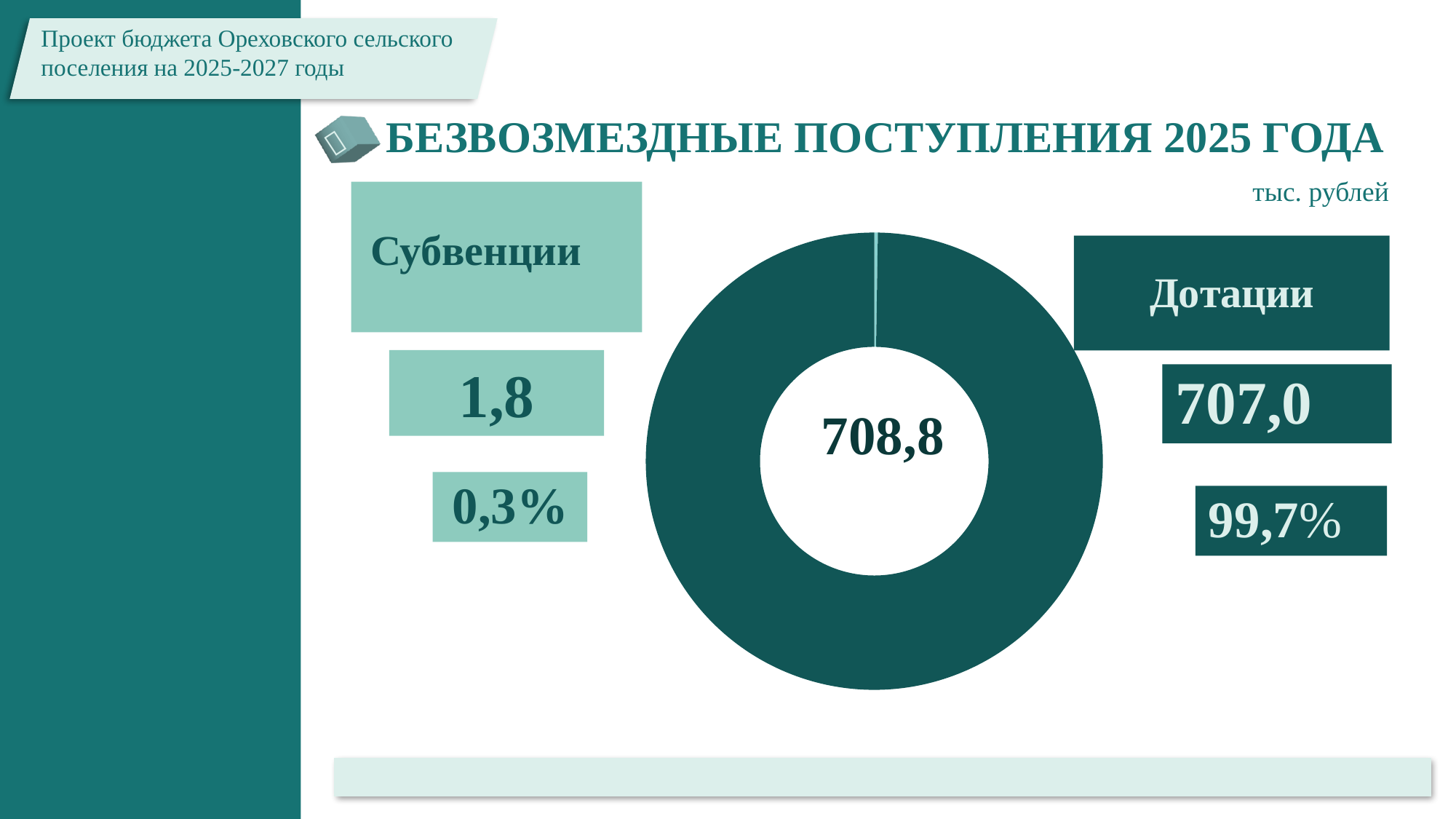
Which category is the largest? Дотации What is the value for Дотации? 707,0 What share of the total do Субвенции make up? 0,3% Which category is the smallest? Субвенции What kind of chart is shown on the slide? Donut (pie) chart What is the total value shown in the centre of the donut chart? 708,8 What share of the total do Дотации make up? 99,7% In what units are the chart values given? тыс. рублей What is the value for Субвенции? 1,8 Which is larger, Дотации or Субвенции? Дотации How many categories does the chart show? 2 What is the difference between the values for Дотации and Субвенции? 705,2